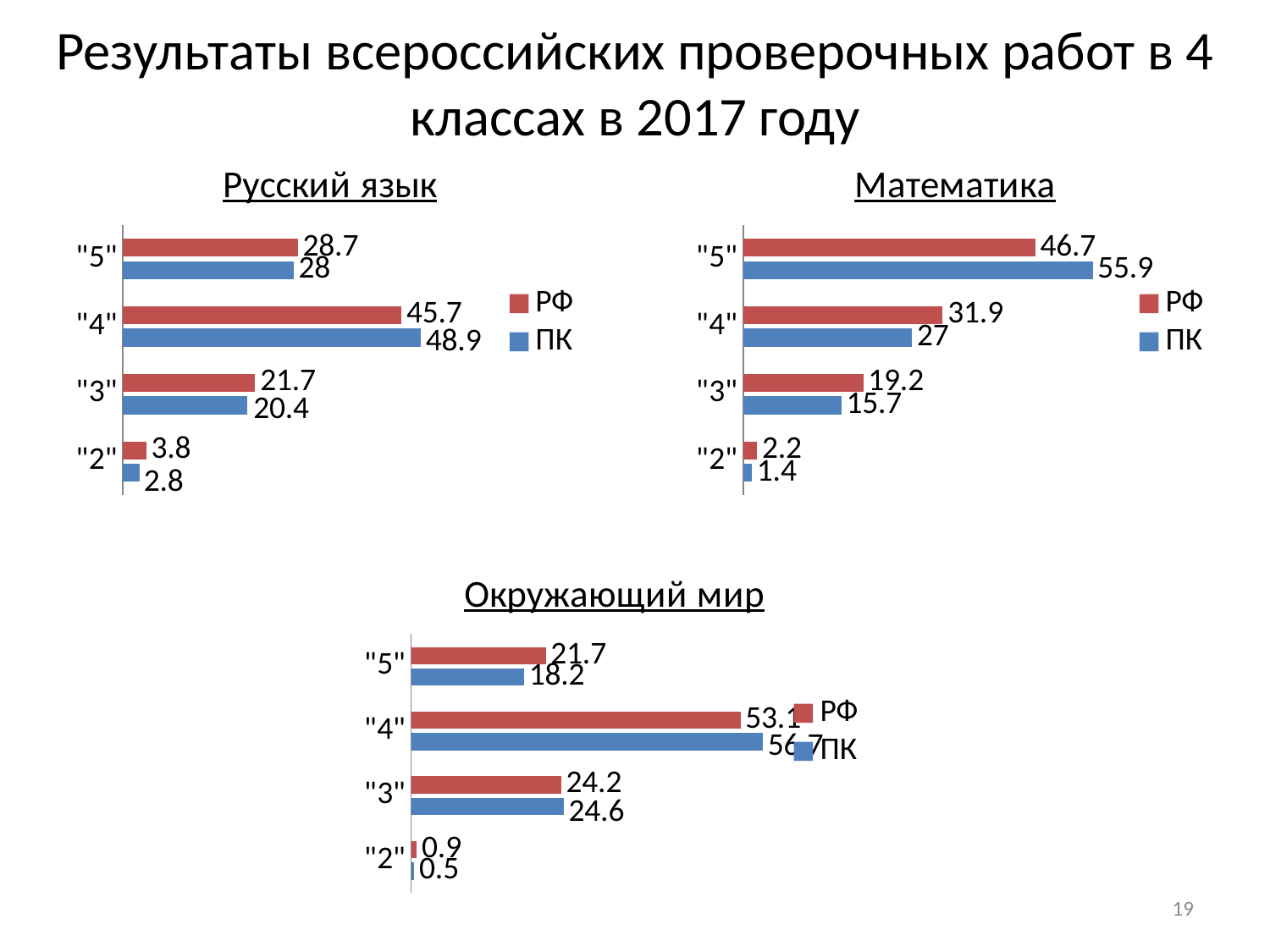
How many series does the legend of the Русский язык chart list? 2 In the Русский язык chart, which is larger in category "4": РФ or ПК? ПК In the Математика chart, what is the value for ПК in category "5"? 55.9 In the Окружающий мир chart, which category has the lowest value for РФ? "2" In the Математика chart, what is the difference between the РФ and ПК values in category "5"? 9.2 How many categories are shown in the Математика chart? 4 In the Математика chart, what is the value for РФ in category "3"? 19.2 In the Окружающий мир chart, what is the value for ПК in category "5"? 18.2 What type of chart is the Окружающий мир chart? Bar chart In the Русский язык chart, what is the value for ПК in category "2"? 2.8 In the Математика chart, which category has the highest value for ПК? "5" In the Русский язык chart, what is the value for РФ in category "4"? 45.7